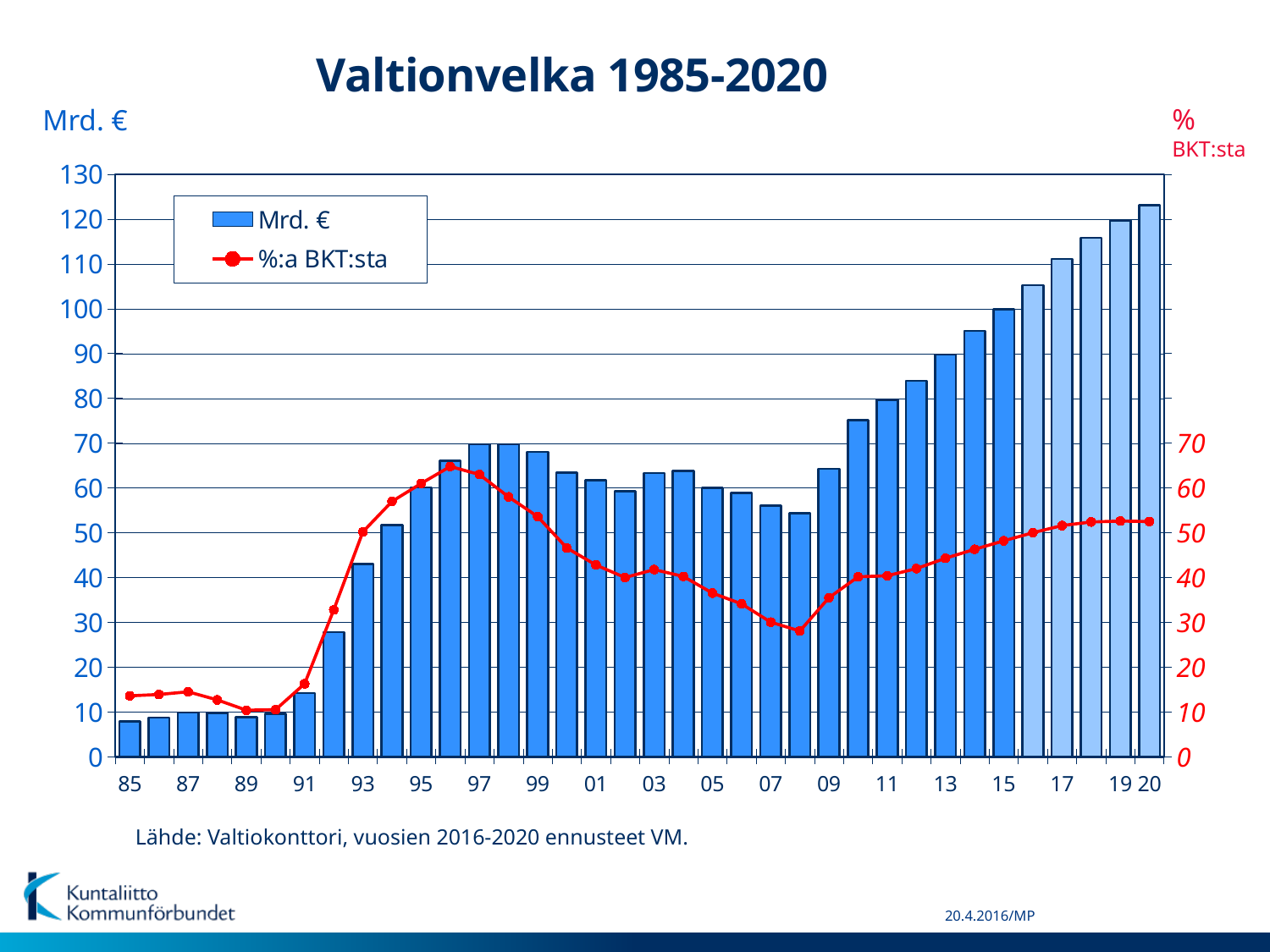
How many series does the legend list? 2 Which year has the lowest Mrd. € bar? 1985 Is the Mrd. € value for 2020 greater or less than 110? greater What kind of chart is shown on the slide? A combined bar and line chart Is the Mrd. € value for 2009 greater or less than 60? greater Is the %:a BKT:sta value for 2008 greater or less than 30? less What are the two series named in the legend? Mrd. € and %:a BKT:sta Which is larger, the Mrd. € bar for 1997 or for 2007? 1997 Do the Mrd. € bars rise or fall from 2008 to 2020? rise Which year has the highest Mrd. € bar? 2020 What is the title of the chart? Valtionvelka 1985-2020